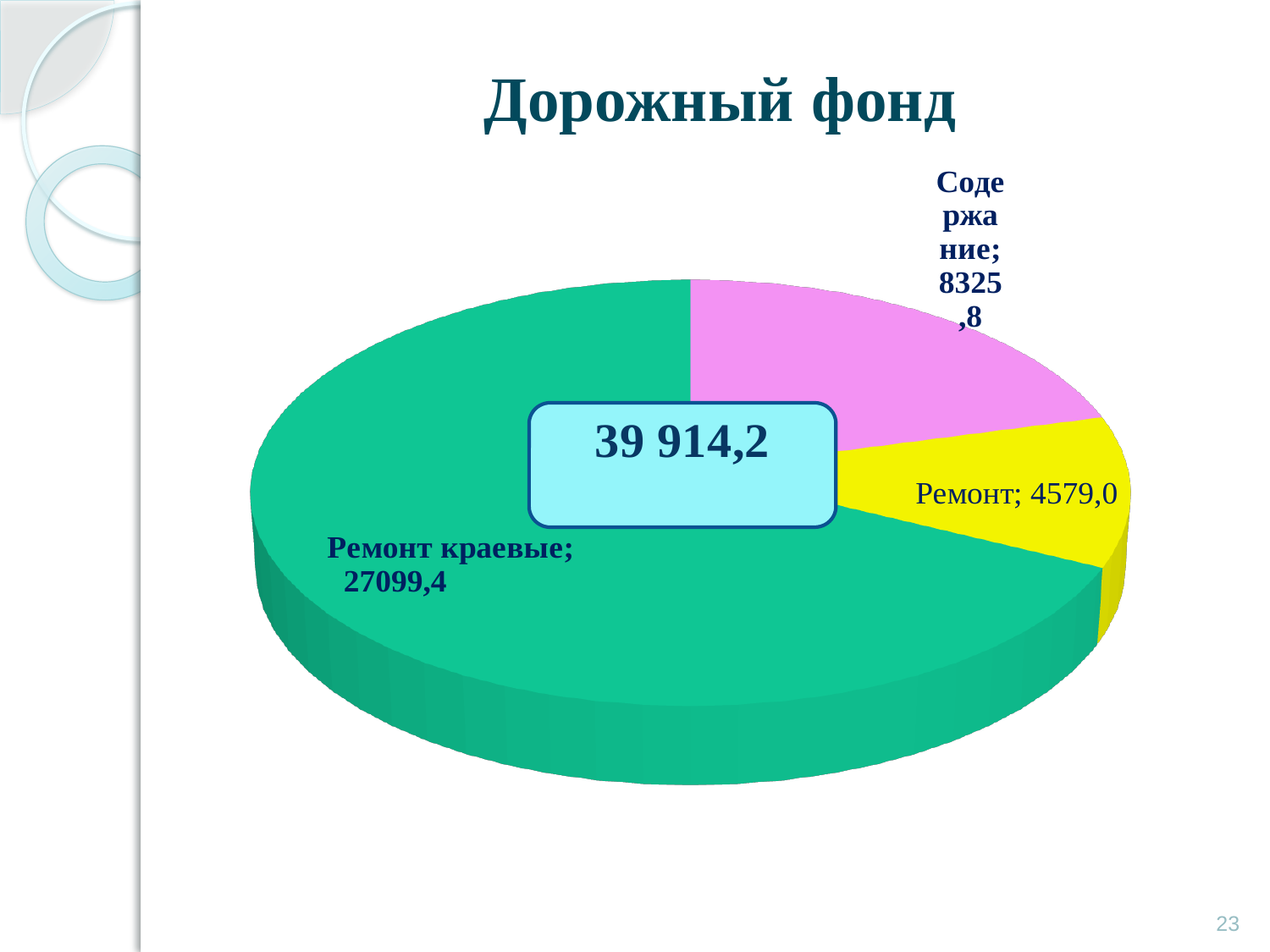
What is the value for Ремонт краевые? 27099,4 What kind of chart is shown on the slide? pie chart What number is shown in the box in the centre of the pie chart? 39 914,2 Which category has the largest slice of the pie? Ремонт краевые Which is larger, the value for Содержание or the value for Ремонт? Содержание Which category has the smallest slice of the pie? Ремонт What is the value for Содержание? 8325,8 What is the title of the slide? Дорожный фонд How many slices does the pie chart have? 3 What is the value for Ремонт? 4579,0 What is the difference between the values for Ремонт краевые and Содержание? 18773,6 What is the difference between the values for Содержание and Ремонт? 3746,8